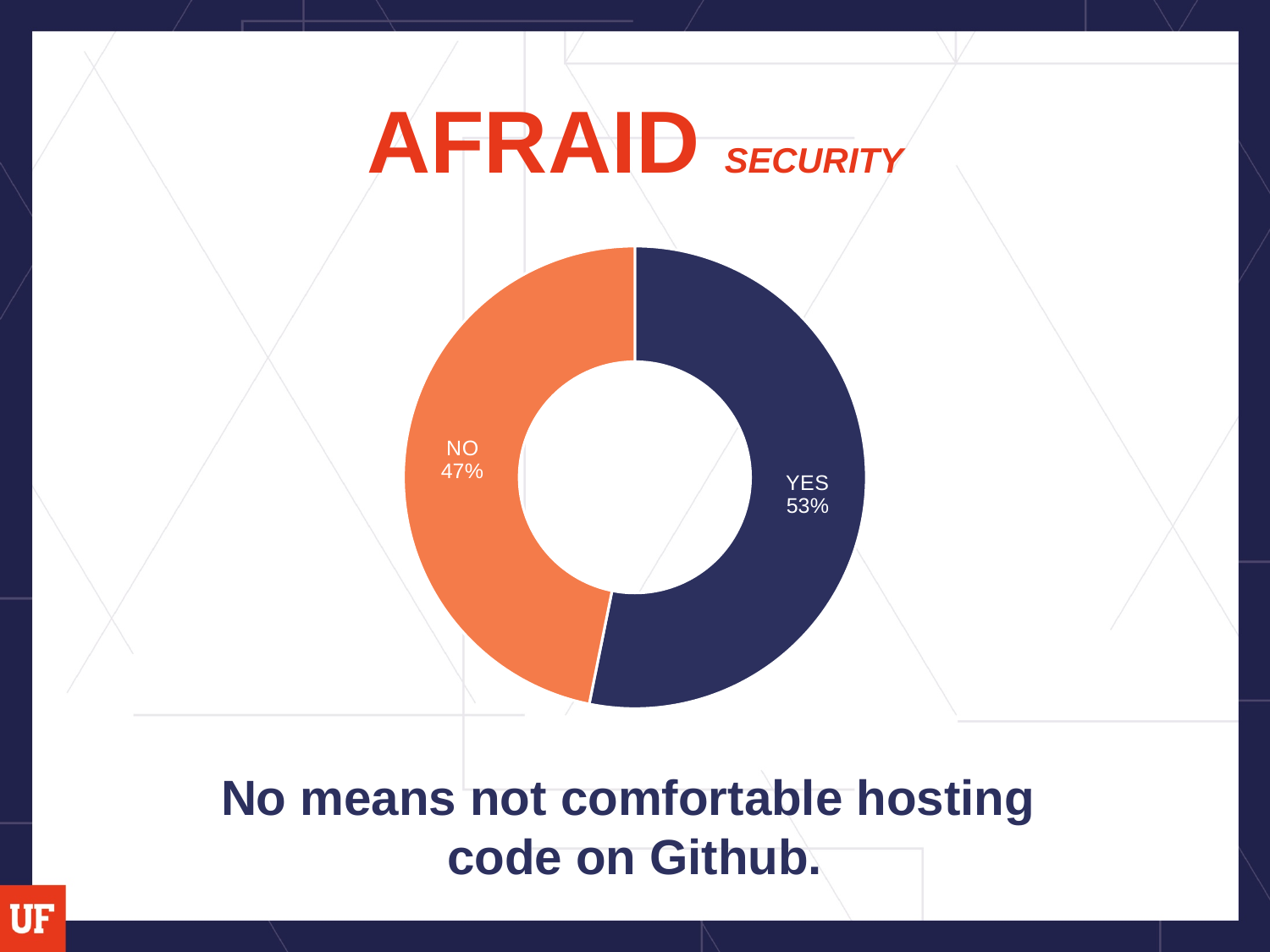
What share of the chart does the NO slice represent? 47% What percentage of the doughnut chart is labelled YES? 53% Which is larger, the YES slice or the NO slice? YES What percentage of the doughnut chart is labelled NO? 47% What colour is the NO slice of the chart? Orange What colour is the YES slice of the chart? Dark blue How many slices does the chart have? 2 What kind of chart is shown on the slide? Doughnut (pie) chart Which slice of the chart is the largest? YES What is the difference in percentage points between the YES and NO slices? 6 Which slice of the chart is the smallest? NO